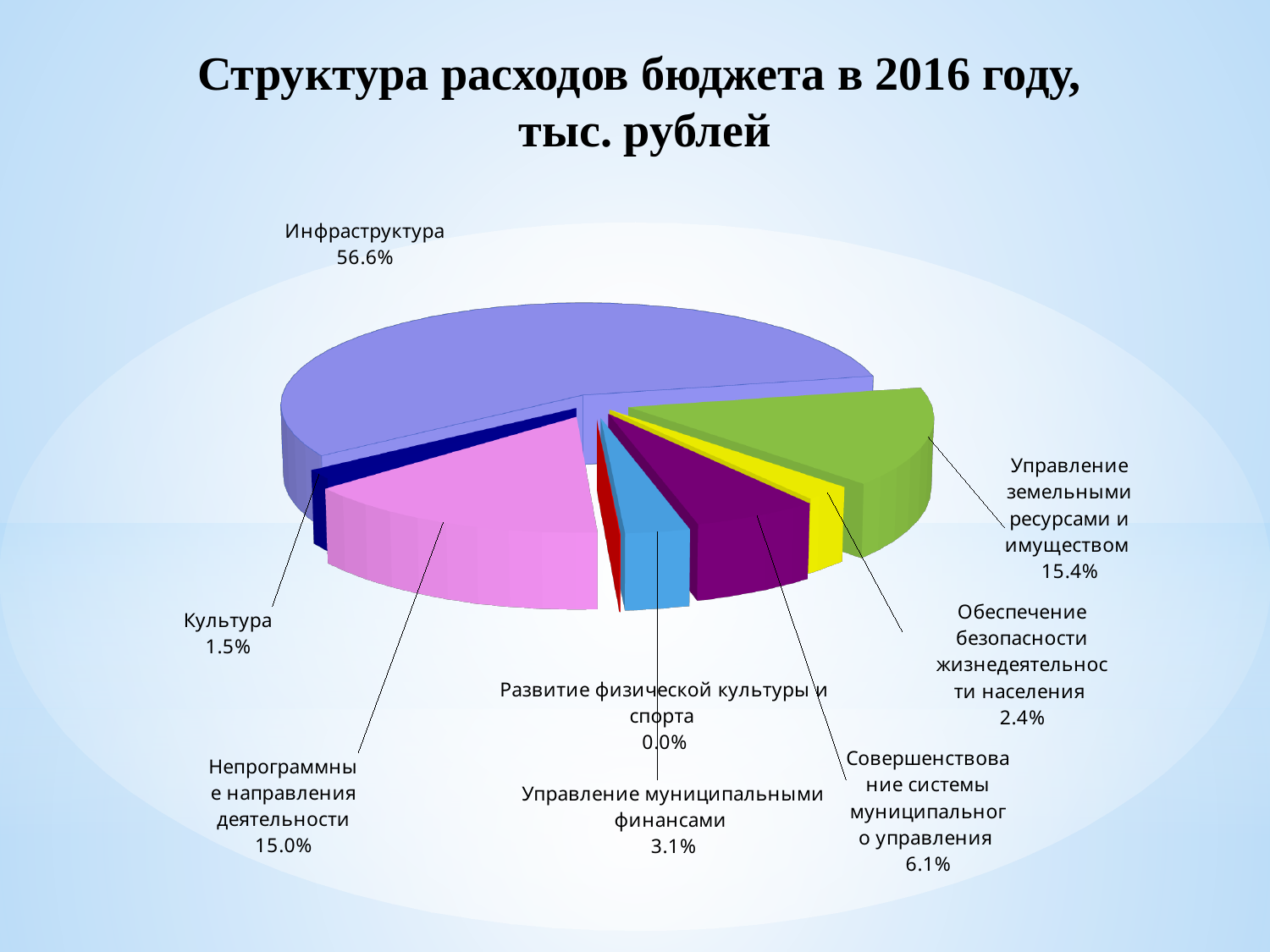
What kind of chart is shown on the slide? Pie chart What share of the pie does Инфраструктура have? 56.6% Which has a larger share: Совершенствование системы муниципального управления or Управление муниципальными финансами? Совершенствование системы муниципального управления Which category has the largest share of the pie? Инфраструктура What share of the pie does Обеспечение безопасности жизнедеятельности населения have? 2.4% What share of the pie does Совершенствование системы муниципального управления have? 6.1% What is the difference in share between Управление земельными ресурсами и имуществом and Непрограммные направления деятельности? 0.4% How many categories are shown in the pie chart? 8 What share of the pie does Культура have? 1.5% What share of the pie does Управление муниципальными финансами have? 3.1% Which category has the smallest share of the pie? Развитие физической культуры и спорта What is the title of the chart? Структура расходов бюджета в 2016 году, тыс. рублей